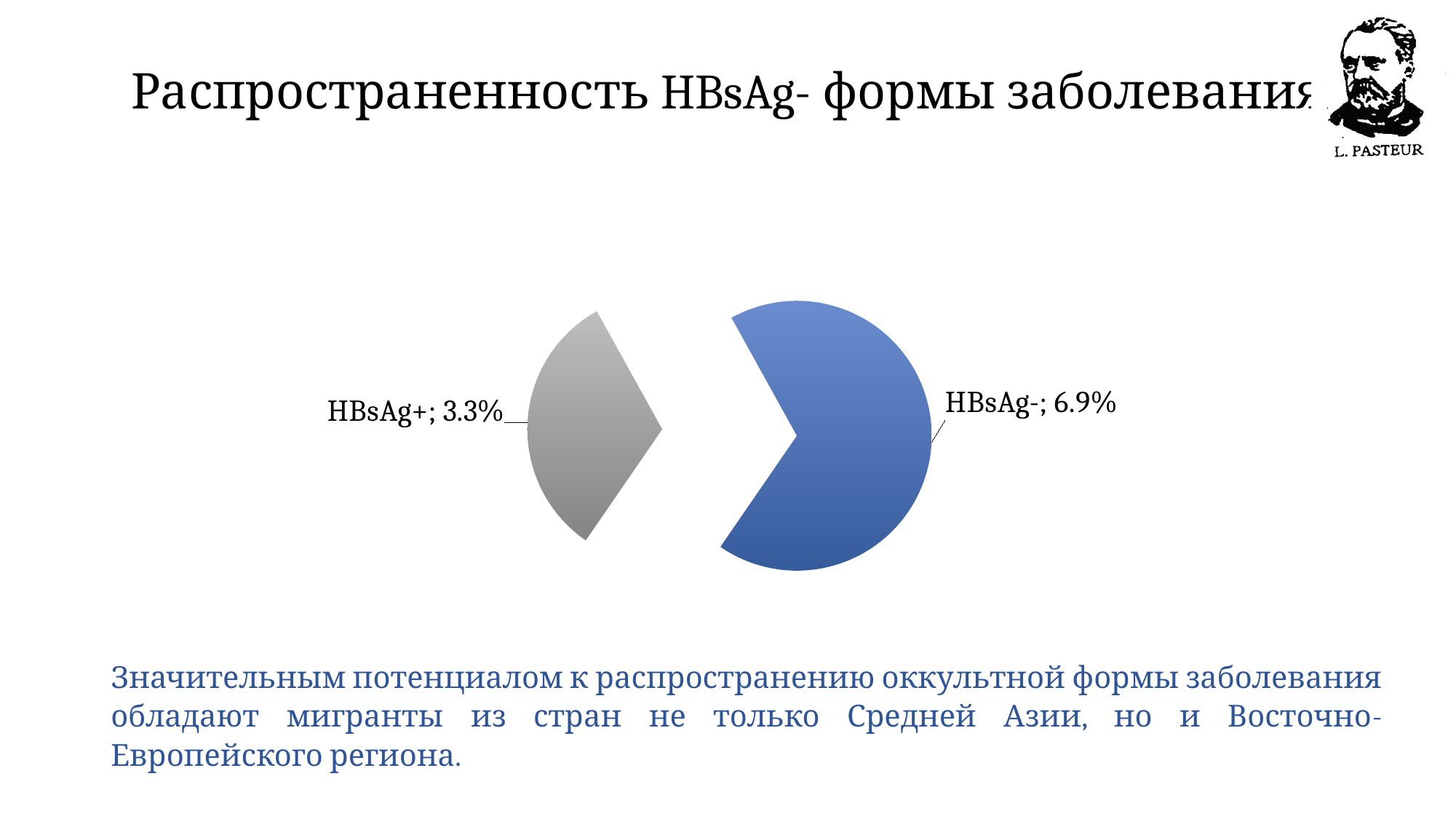
Which slice has the lowest value? HBsAg+ What colour is the HBsAg- slice? blue What value is shown for the HBsAg+ slice? 3.3% What type of chart is shown on the slide? pie chart What colour is the HBsAg+ slice? grey What is the difference between the HBsAg- value and the HBsAg+ value? 3.6% Which is larger, the value for HBsAg+ or the value for HBsAg-? HBsAg- What value is shown for the HBsAg- slice? 6.9% Which slice has the highest value? HBsAg- How many slices does the pie chart have? 2